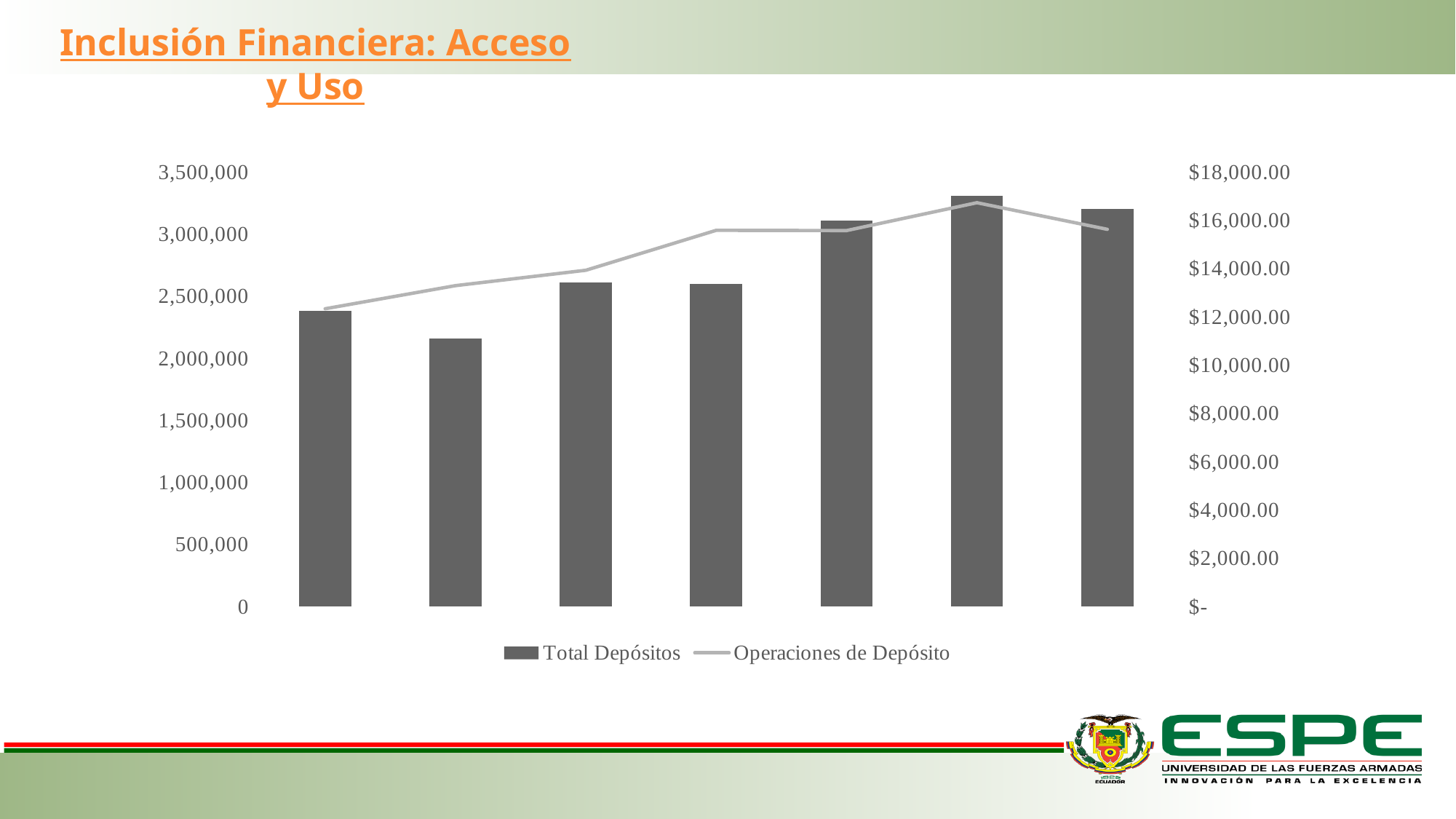
Which bar is the tallest for Total Depósitos, counting from the left? the sixth bar What kind of chart is shown on the slide? bar chart with a line Which series is drawn as a line rather than bars? Operaciones de Depósito What are the two legend entries of the chart? Total Depósitos and Operaciones de Depósito Which is larger for Total Depósitos: the first bar from the left or the second bar from the left? the first bar Is the Total Depósitos value for the second bar from the left greater or less than 2,500,000? less Which bar is the shortest for Total Depósitos, counting from the left? the second bar Is the Total Depósitos value for the fifth bar from the left greater or less than 3,000,000? greater How many bars are plotted in the chart? 7 Is the Total Depósitos value for the sixth bar from the left greater or less than 3,000,000? greater How many series does the legend list? 2 Does the Operaciones de Depósito line generally rise or fall from left to right? rise